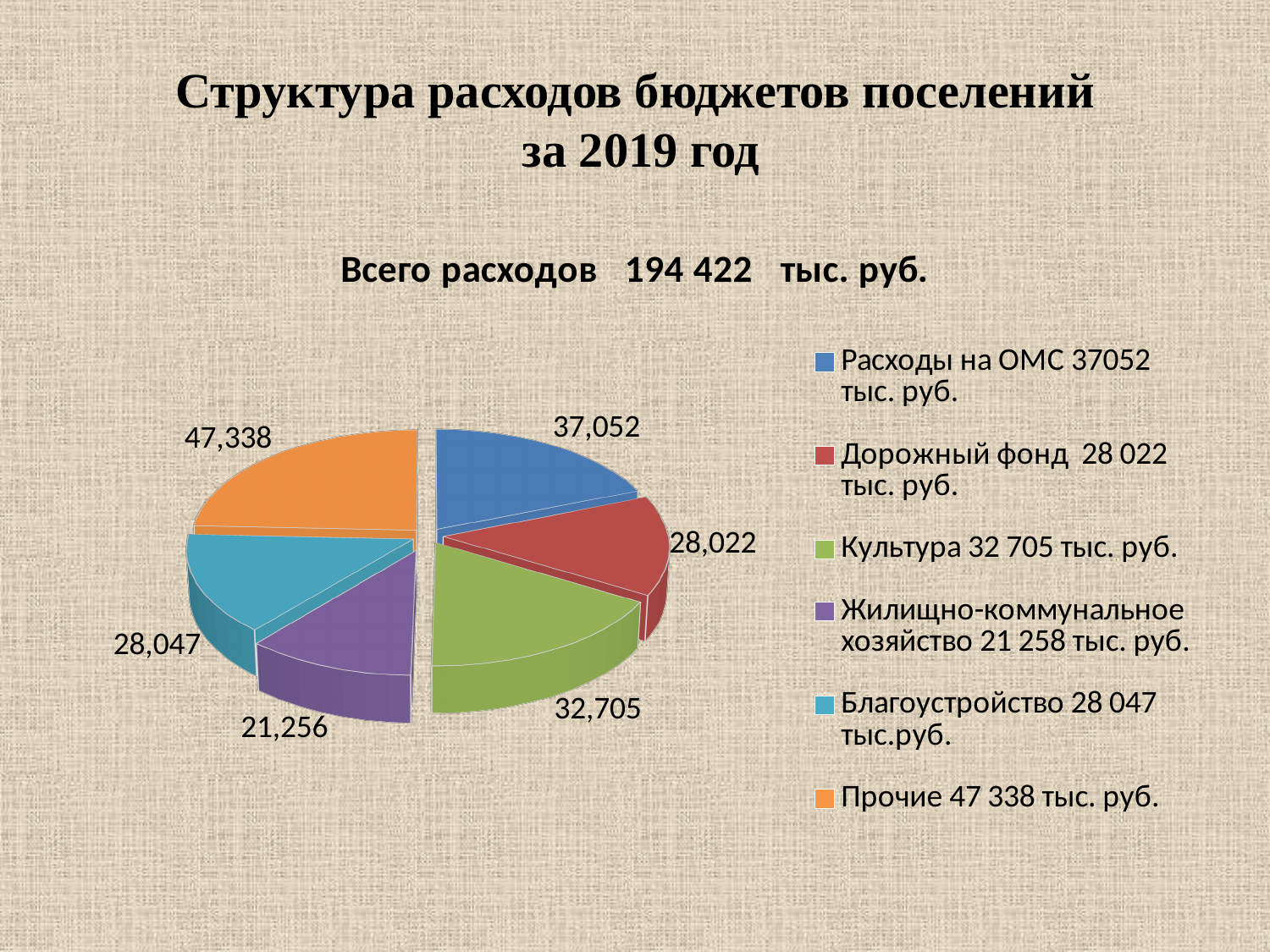
Which is larger, the value for Культура or the value for Дорожный фонд? Культура What total expenditure is stated above the chart? 194 422 тыс. руб. How many slices does the pie chart have? 6 What is the value shown for Прочие? 47,338 What is the value shown for Культура? 32,705 What is the value shown for Расходы на ОМС? 37,052 What is the difference between the values for Прочие and Расходы на ОМС? 10,286 What is the difference between the values for Культура and Дорожный фонд? 4,683 Which category has the smallest slice of the pie? Жилищно-коммунальное хозяйство What kind of chart is shown on the slide? Pie chart How many entries does the legend list? 6 Which category has the largest slice of the pie? Прочие